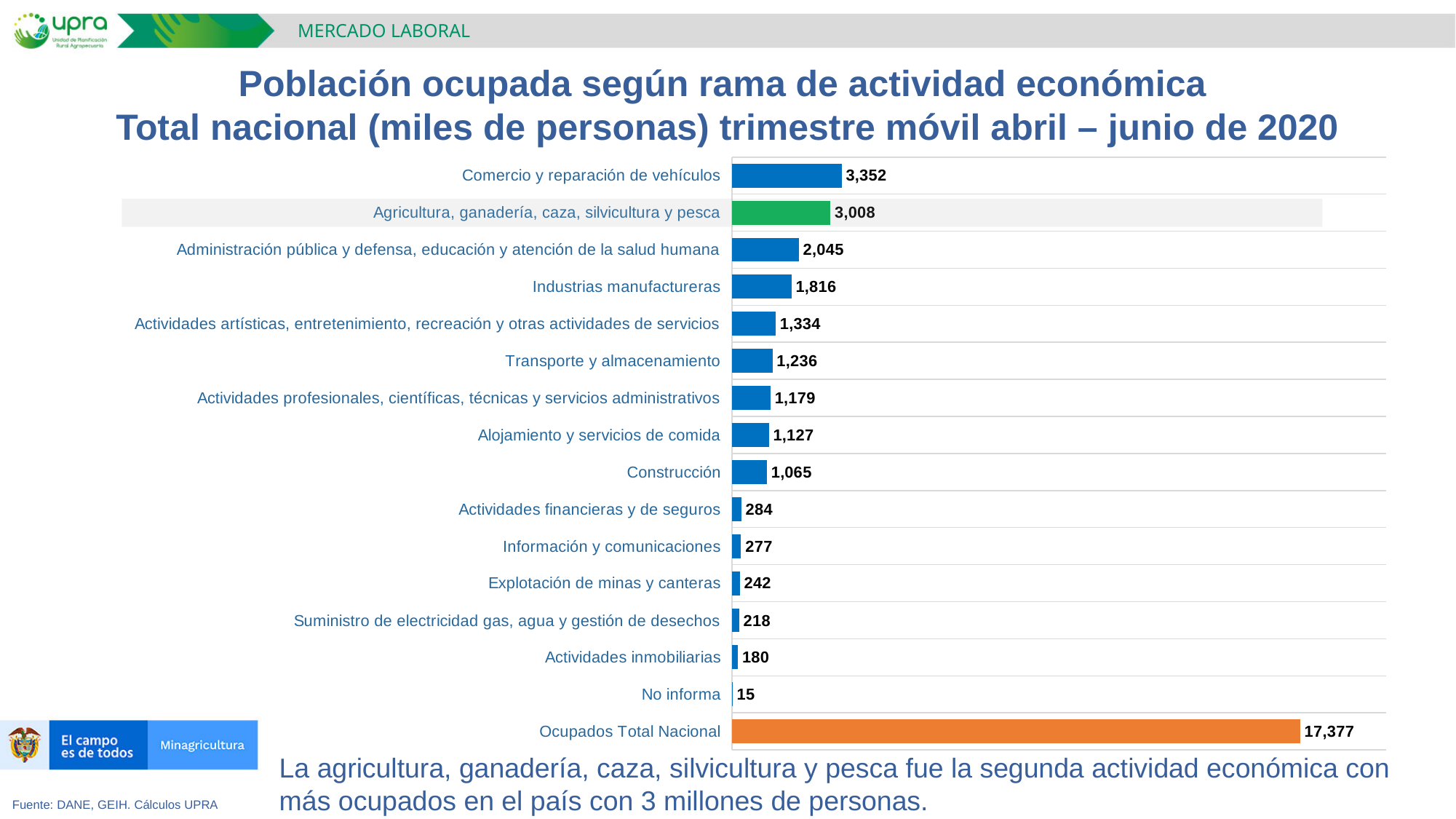
What is the value for Ocupados Total Nacional? 17,377 What kind of chart is shown on the slide? Bar chart How many bars are plotted in the chart, including the Ocupados Total Nacional bar? 16 What is the difference between Administración pública y defensa, educación y atención de la salud humana and Industrias manufactureras? 229 Which category's bar is coloured green? Agricultura, ganadería, caza, silvicultura y pesca What is the value for Construcción? 1,065 Which category has the lowest value? No informa Which is larger, Transporte y almacenamiento or Alojamiento y servicios de comida? Transporte y almacenamiento What is the difference between Comercio y reparación de vehículos and Agricultura, ganadería, caza, silvicultura y pesca? 344 What is the value for Agricultura, ganadería, caza, silvicultura y pesca? 3,008 Excluding the Ocupados Total Nacional bar, which economic activity has the highest value? Comercio y reparación de vehículos What is the value for Comercio y reparación de vehículos? 3,352